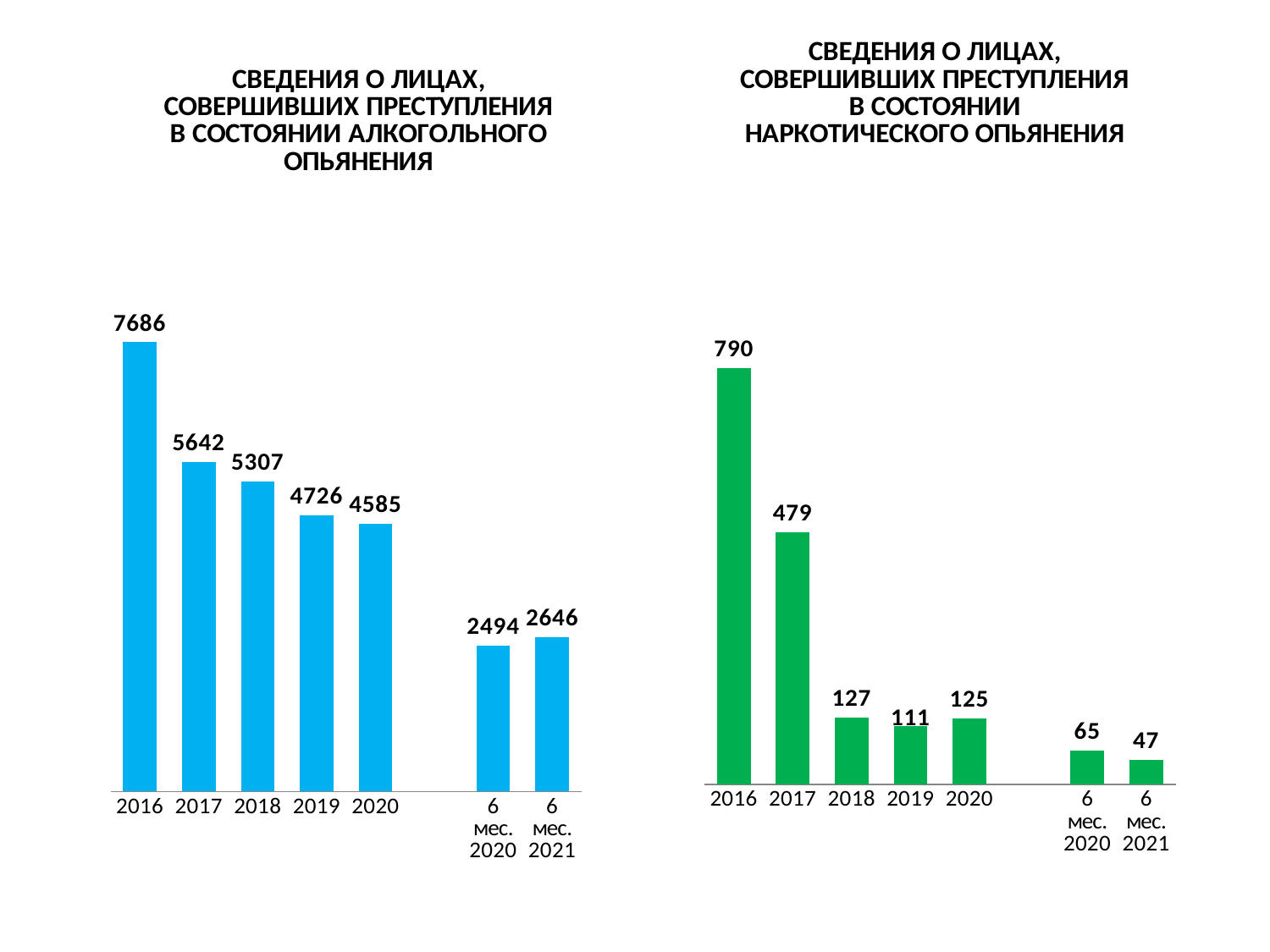
In the right chart (narcotic intoxication), which is larger: the value for 2018 or the value for 2019? 2018 In the left chart (alcohol intoxication), what is the value for 6 мес. 2021? 2646 In the left chart (alcohol intoxication), do the values rise or fall from 2016 to 2020? fall In the left chart (alcohol intoxication), what is the value for 2016? 7686 In the left chart (alcohol intoxication), which category has the highest value? 2016 What type of chart is the right chart (narcotic intoxication)? bar chart In the left chart (alcohol intoxication), what is the difference between the values for 2017 and 2018? 335 In the right chart (narcotic intoxication), which category has the lowest value? 6 мес. 2021 How many bars are shown in the left chart (alcohol intoxication)? 7 In the right chart (narcotic intoxication), what is the value for 2017? 479 In the right chart (narcotic intoxication), what is the value for 6 мес. 2020? 65 In the right chart (narcotic intoxication), what is the difference between the values for 2016 and 2017? 311